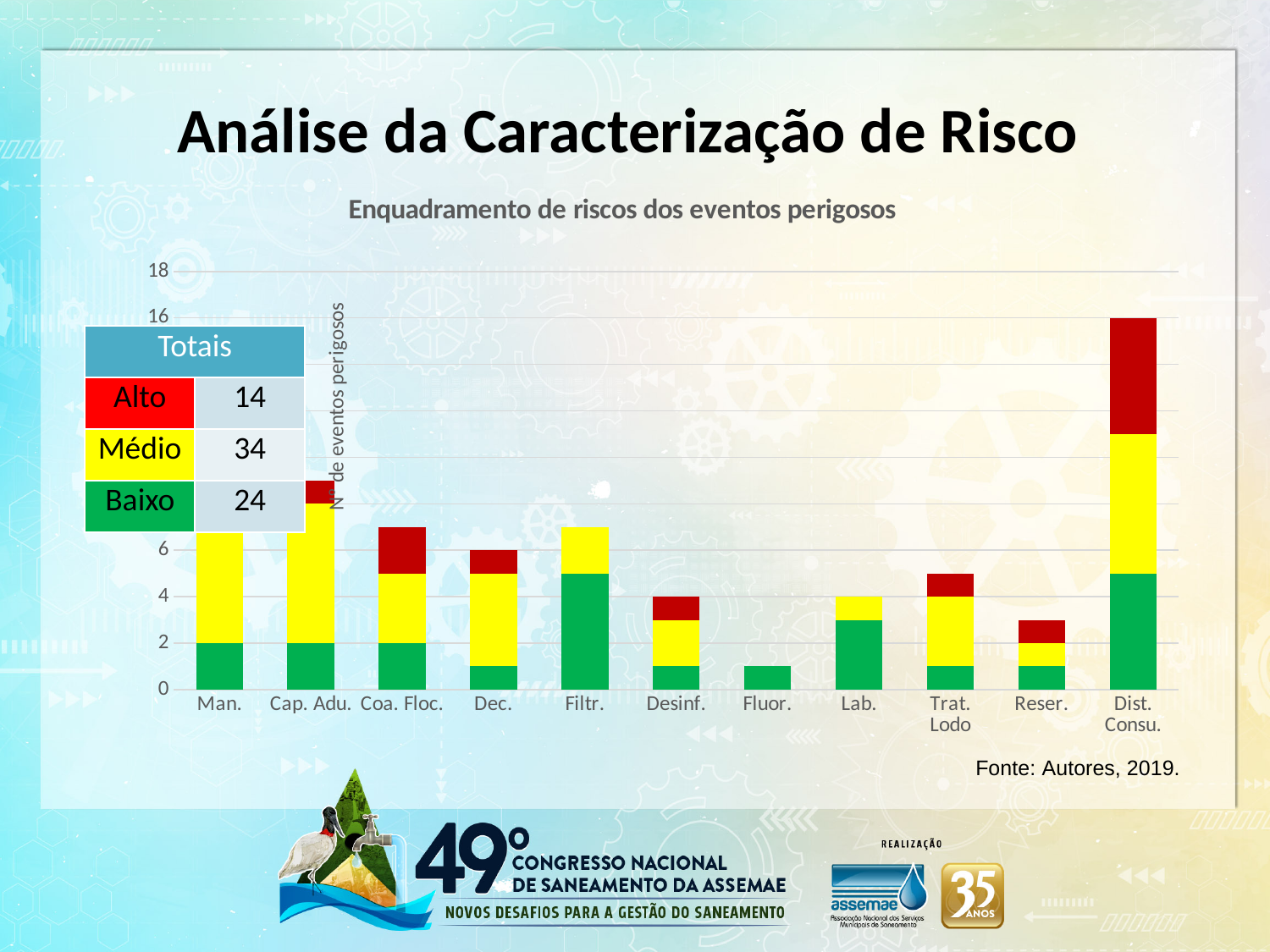
Is the total value for Coa. Floc. greater or less than 6? greater Which category has the shortest bar in the chart? Fluor. How many risk levels does the Totais table list? 3 How many categories are shown along the x axis of the chart? 11 According to the Totais table, what is the total for Médio? 34 What is the title of the chart? Enquadramento de riscos dos eventos perigosos What is the total height of the stacked bar for Dec.? 6 Which category has the tallest bar in the chart? Dist. Consu. Which has a taller bar, Filtr. or Desinf.? Filtr. What is the total height of the stacked bar for Dist. Consu.? 16 What kind of chart is shown on the slide? bar chart Is the total value for Reser. greater or less than 4? less